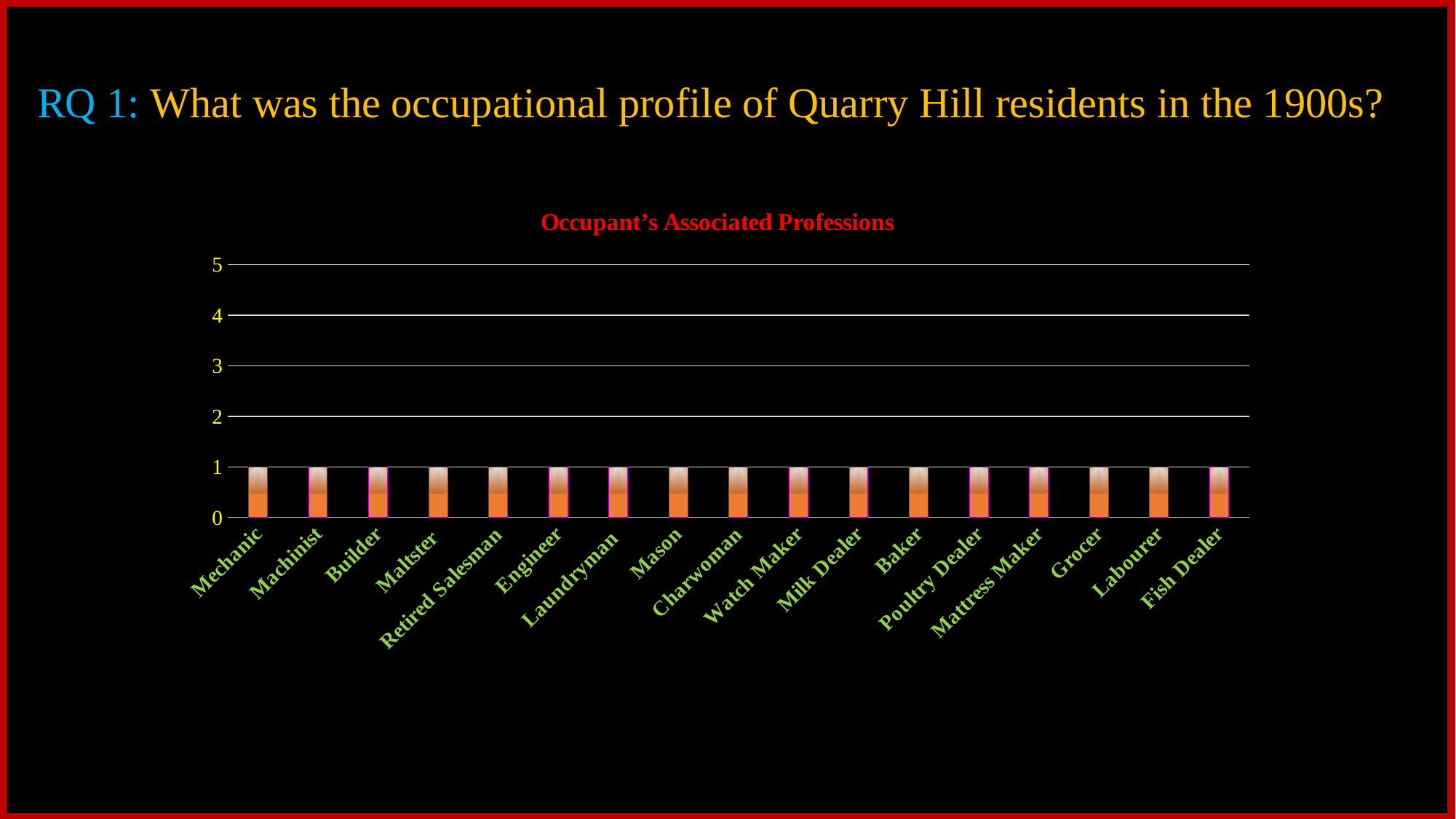
What is the value for Mechanic? 1 What is the value for Fish Dealer? 1 Is the value for Mason greater or less than 2? less What is the value for Charwoman? 1 How many professions are shown on the x axis of the chart? 17 What is the value for Poultry Dealer? 1 What is the value for Retired Salesman? 1 What is the title of the chart? Occupant's Associated Professions What kind of chart is shown on the slide? bar chart What is the highest value shown on the y axis of the chart? 5 What is the difference between the values for Baker and Grocer? 0 Do the values rise, fall, or stay the same across the professions along the x axis? stay the same